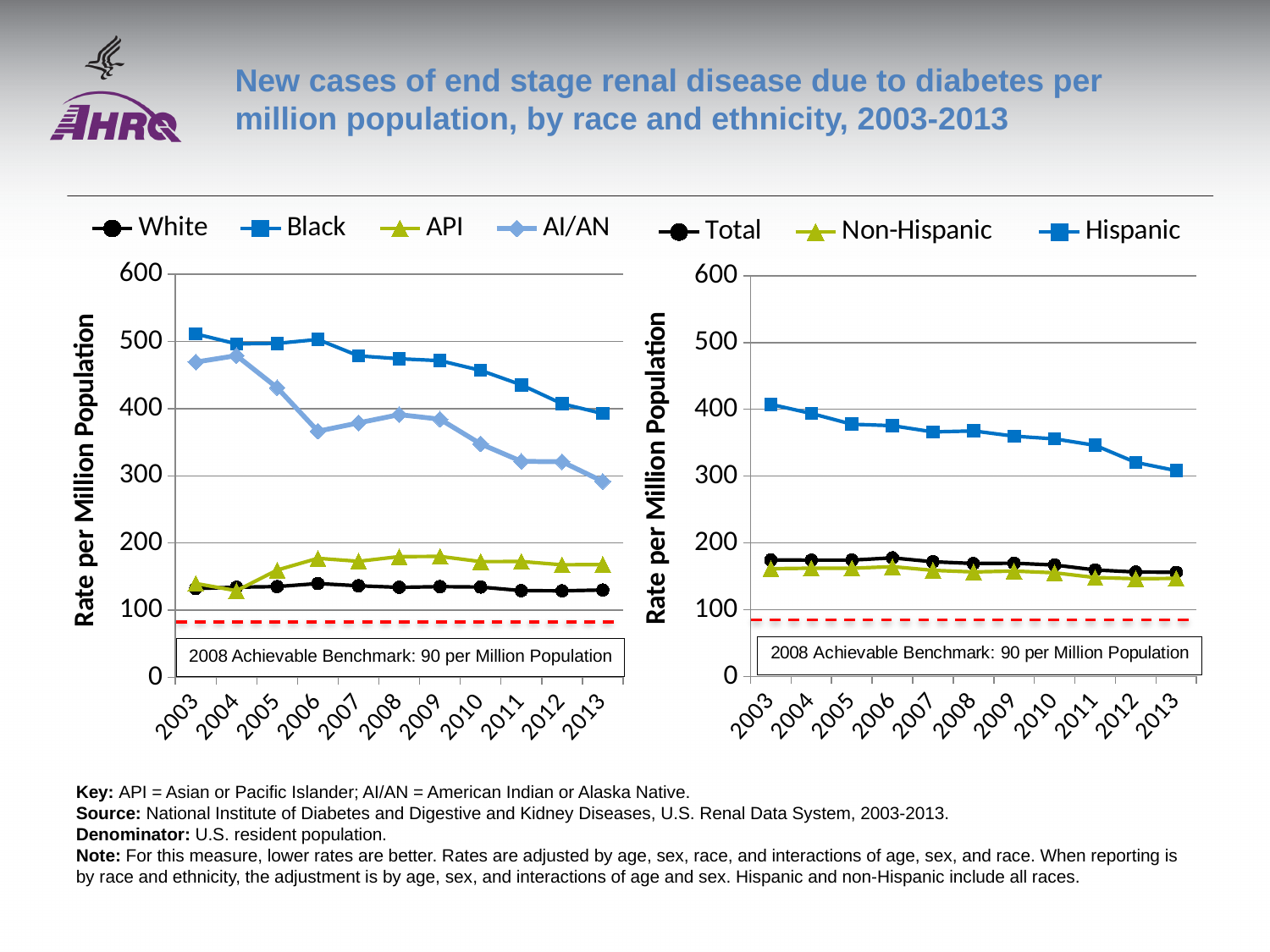
How many years are shown on the x axis of the right chart? 11 In the right chart, does the Hispanic rate rise or fall from 2003 to 2013? fall What kind of chart is the left chart on the slide? line chart In the left chart, is the value for AI/AN in 2013 greater or less than 300? less In the right chart, is the value for Hispanic in 2003 greater or less than 400? greater In the left chart, is the value for Black in 2003 greater or less than 500? greater How many series does the legend of the left chart list? 4 What value does the dashed red line in each chart represent, according to the label on the slide? 2008 Achievable Benchmark: 90 per Million Population In the left chart, which group has the lowest rate in 2013? White In the left chart, which group has the highest rate in 2003? Black How many series does the legend of the right chart list? 3 In the right chart, which is larger in 2013, the Hispanic rate or the Total rate? Hispanic